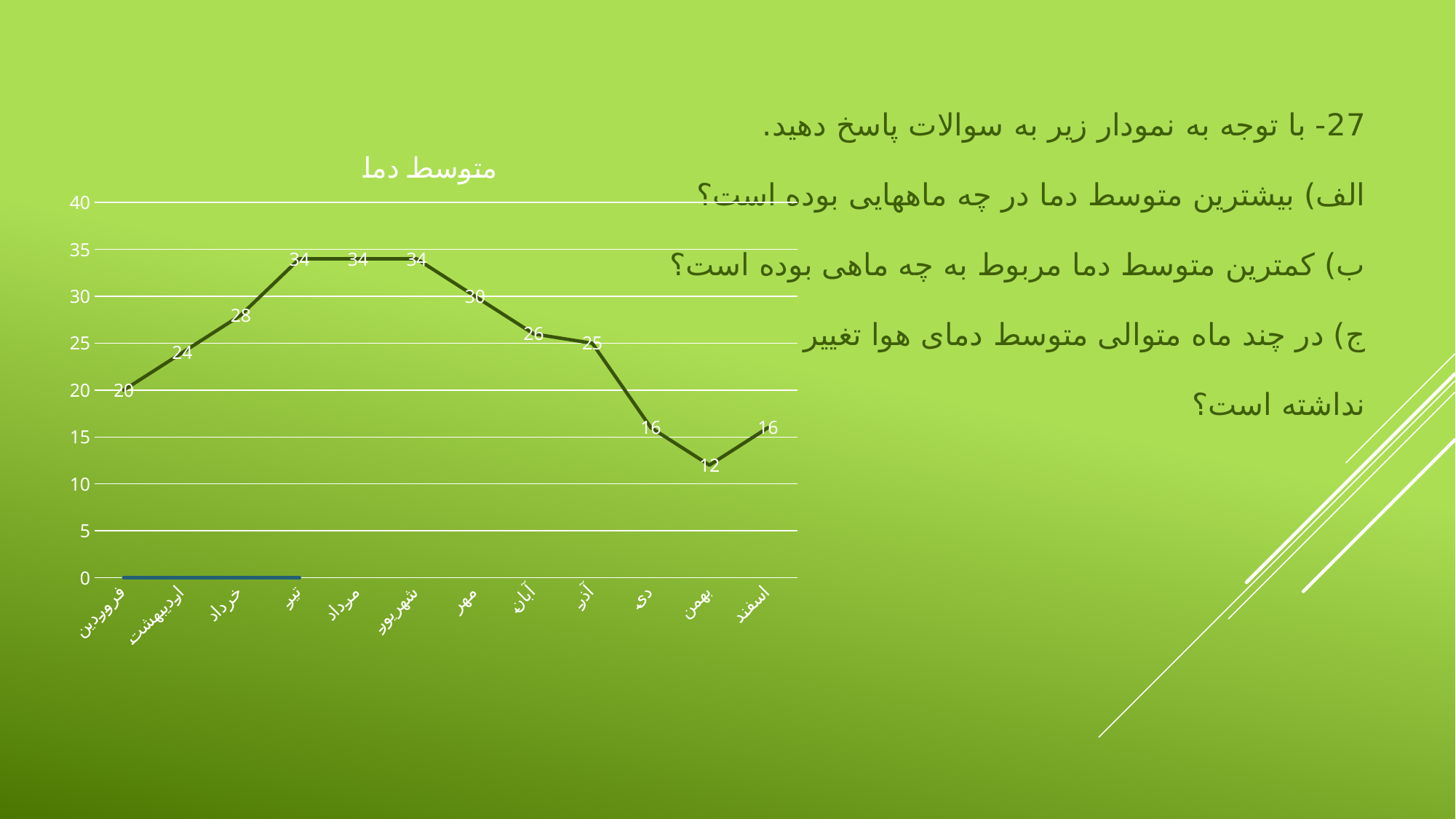
What is the value for آذر? 25 Which is larger, the value for اردیبهشت or the value for آبان? آبان What is the value for خرداد? 28 What is the value for مهر? 30 What is the difference between the values for تیر and بهمن? 22 What is the value for فروردین? 20 What type of chart is shown on the slide? line chart Do the values rise or fall from فروردین to تیر? rise Which month has the lowest value? بهمن What is the highest value shown on the chart? 34 How many months are plotted on the x axis of the chart? 12 What is the title of the chart? متوسط دما